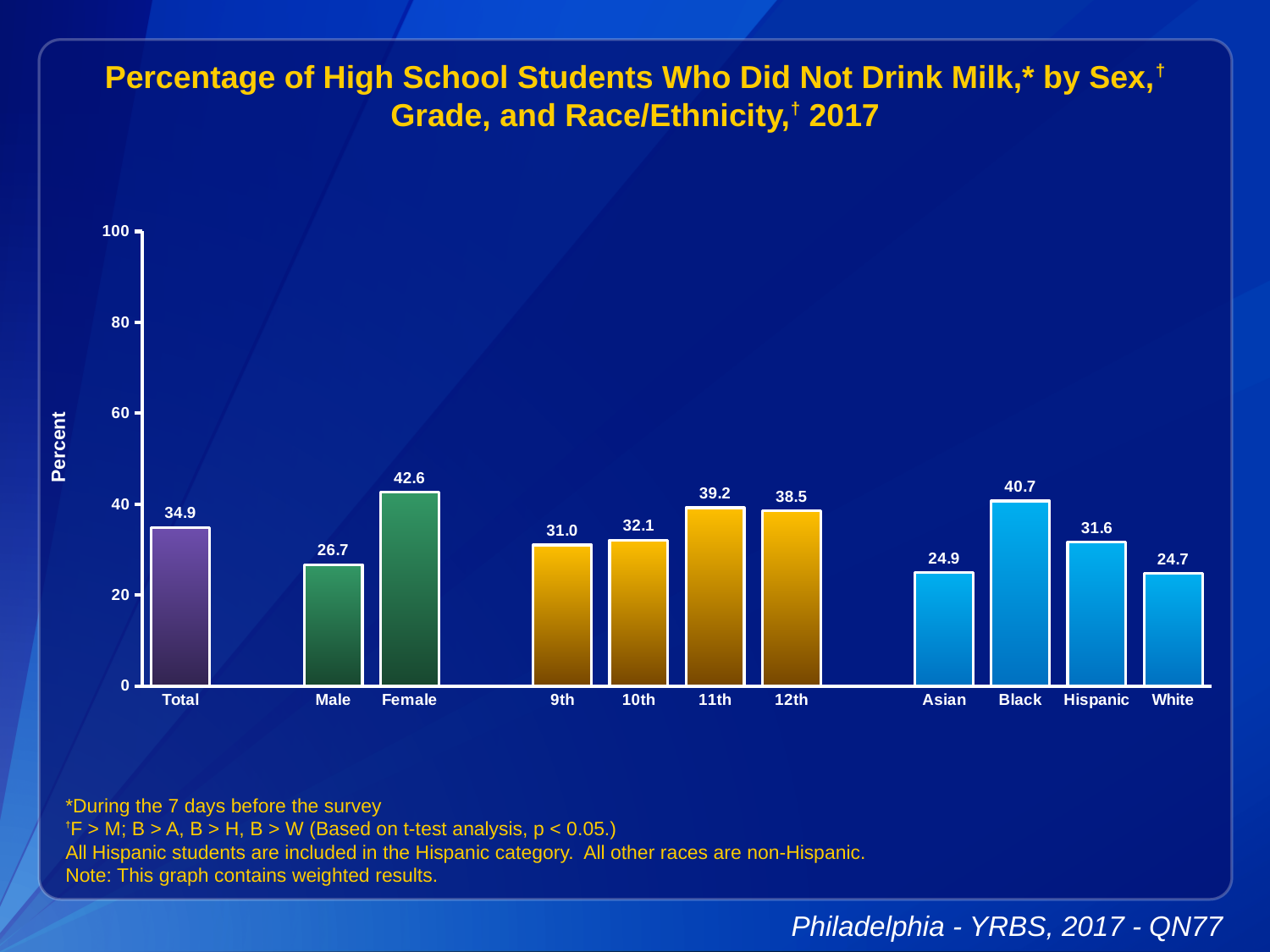
What is the label of the y axis? Percent What is the value for 11th grade? 39.2 What is the value for Total? 34.9 What is the difference between the Female and Male values? 15.9 Which category has the highest value? Female Which is larger, the value for Black or the value for Asian? Black What is the value for Female? 42.6 How many categories are shown on the x axis? 11 Which category has the lowest value? White What is the value for Hispanic? 31.6 Is the value for 12th grade greater or less than 20? greater What kind of chart is this? bar chart